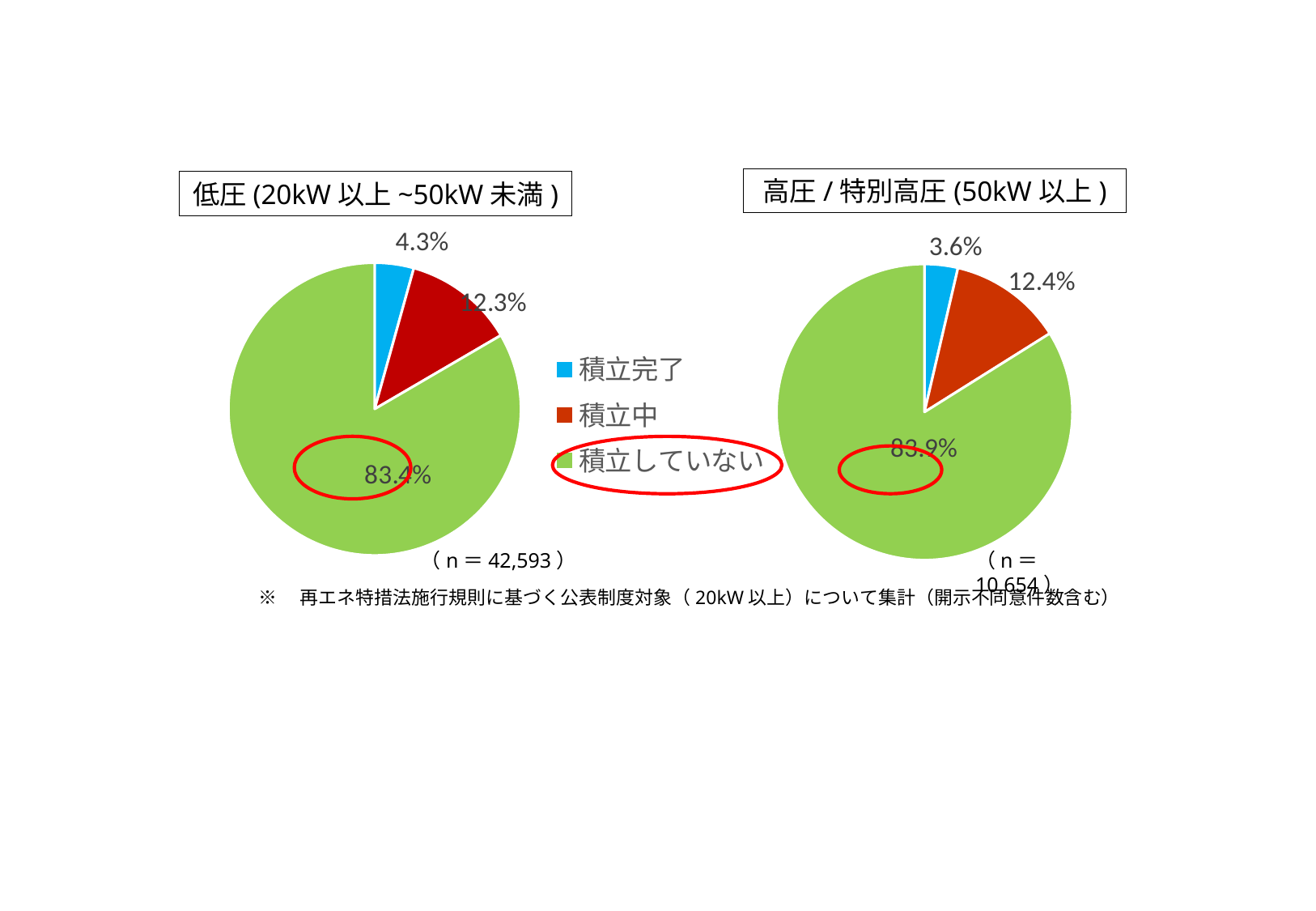
In the left pie chart (低圧), which category has the largest share? 積立していない In the left pie chart (低圧), what percentage is shown for 積立中? 12.3% How many categories does each pie chart show? 3 In the right pie chart (高圧/特別高圧), which category has the smallest share? 積立完了 In the right pie chart (高圧/特別高圧 (50kW以上)), what percentage is shown for 積立完了? 3.6% What is the sample size (n) shown for the left pie chart (低圧)? 42,593 What is the difference between the 積立していない share in the right pie chart (83.9%) and in the left pie chart (83.4%)? 0.5% In the right pie chart (高圧/特別高圧), what percentage is shown for 積立中? 12.4% What type of chart is used on this slide? Pie chart Which is larger: the 積立完了 share in the left pie chart (低圧) or in the right pie chart (高圧/特別高圧)? Left pie chart (低圧), 4.3% In the left pie chart (低圧 (20kW以上~50kW未満)), what percentage is shown for 積立していない? 83.4% Which legend entry is circled in red on the slide? 積立していない